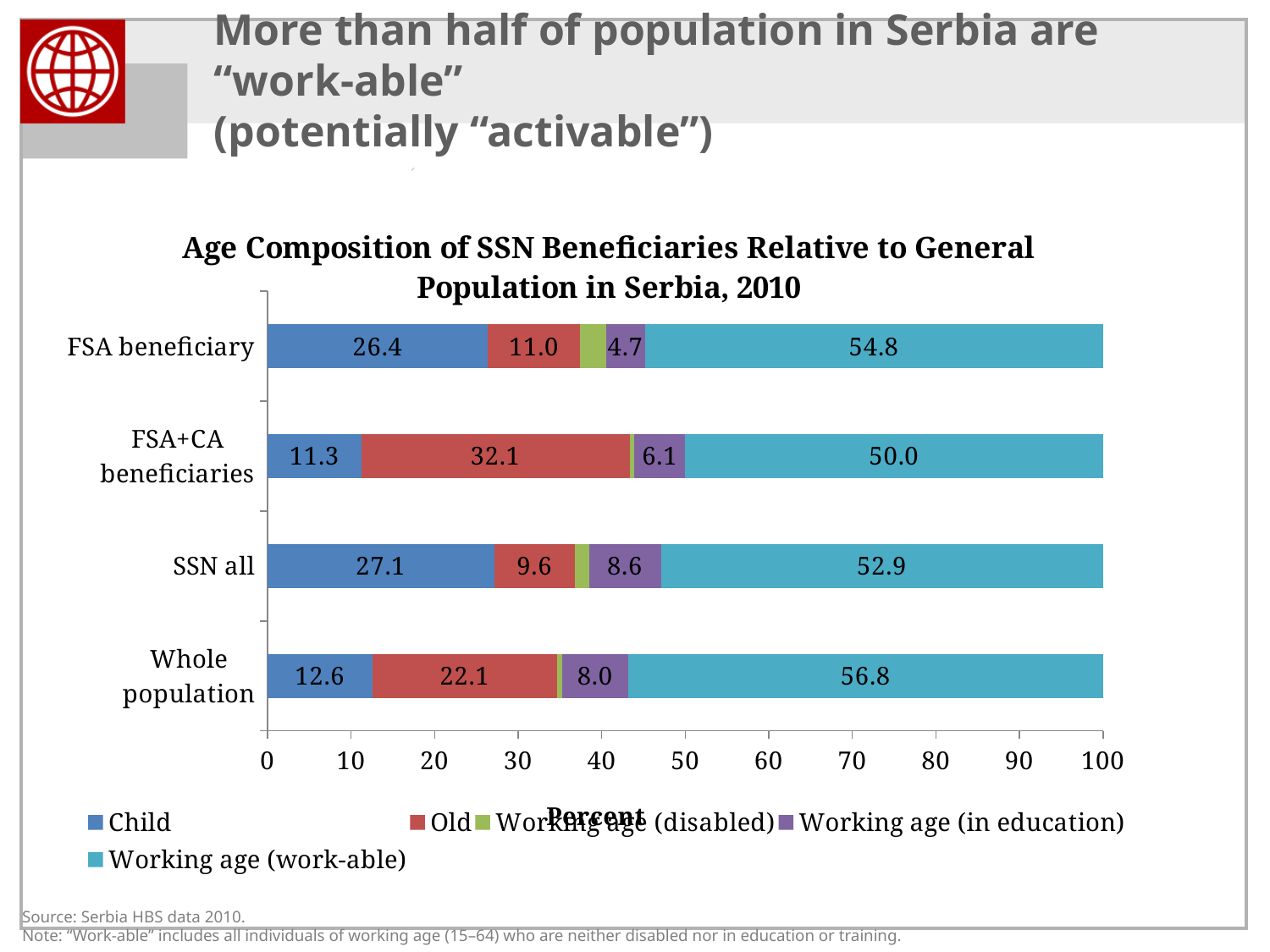
Which category has the highest Working age (work-able) value? Whole population What is the title of the chart? Age Composition of SSN Beneficiaries Relative to General Population in Serbia, 2010 Is the Old value larger for FSA+CA beneficiaries or for SSN all? FSA+CA beneficiaries What is the Old value for FSA+CA beneficiaries? 32.1 Which category has the lowest Child value? FSA+CA beneficiaries What is the Child value for SSN all? 27.1 What is the Working age (work-able) value for the Whole population? 56.8 What is the difference between the Child value for FSA beneficiary and the Child value for Whole population? 13.8 How many categories are plotted on the y axis? 4 How many series does the legend list? 5 What kind of chart is shown on the slide? stacked bar chart What is the Working age (in education) value for FSA beneficiary? 4.7